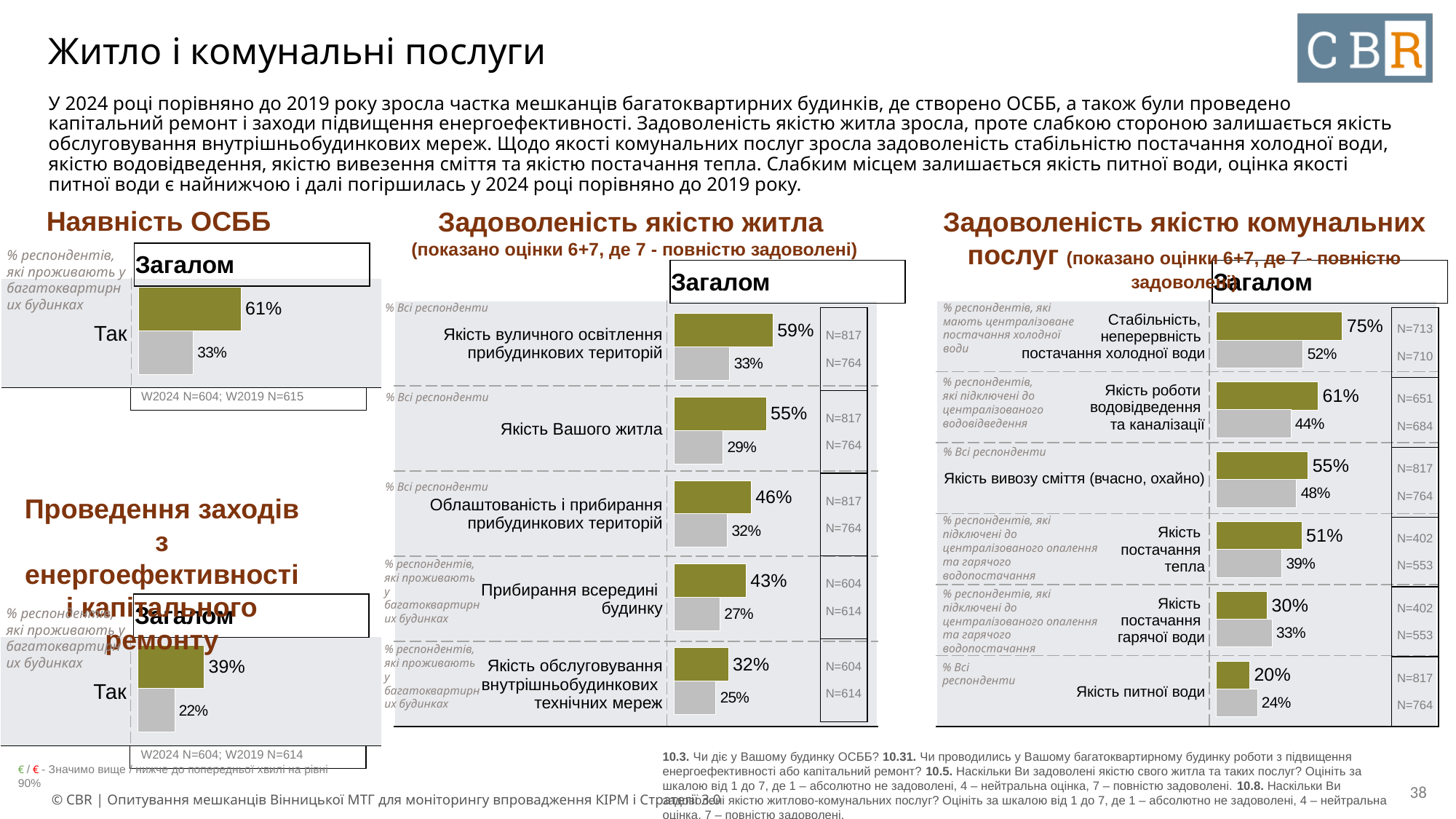
In the 'Задоволеність якістю комунальних послуг' chart, what is the olive bar value for 'Якість питної води'? 20% In the 'Задоволеність якістю комунальних послуг' chart, which category has the highest olive bar value? Стабільність, неперервність постачання холодної води In the 'Задоволеність якістю комунальних послуг' chart, which is larger for 'Якість постачання гарячої води': the olive bar or the grey bar? the grey bar In the 'Наявність ОСББ' chart, what value is shown on the olive bar for 'Так'? 61% What type of chart is used for 'Задоволеність якістю комунальних послуг'? bar chart In the 'Проведення заходів з енергоефективності і капітального ремонту' chart, what is the difference between the olive bar value and the grey bar value? 17% In the 'Наявність ОСББ' chart, what value is shown on the grey bar for 'Так'? 33% In the 'Задоволеність якістю комунальних послуг' chart, what is the difference between the olive and grey bar values for 'Якість роботи водовідведення та каналізації'? 17% In the 'Задоволеність якістю житла' chart, which category has the lowest olive bar value? Якість обслуговування внутрішньобудинкових технічних мереж How many categories are shown in the 'Задоволеність якістю житла' chart? 5 In the 'Задоволеність якістю житла' chart, which category has the highest olive bar value? Якість вуличного освітлення прибудинкових територій In the 'Задоволеність якістю житла' chart, what is the olive bar value for 'Якість Вашого житла'? 55%